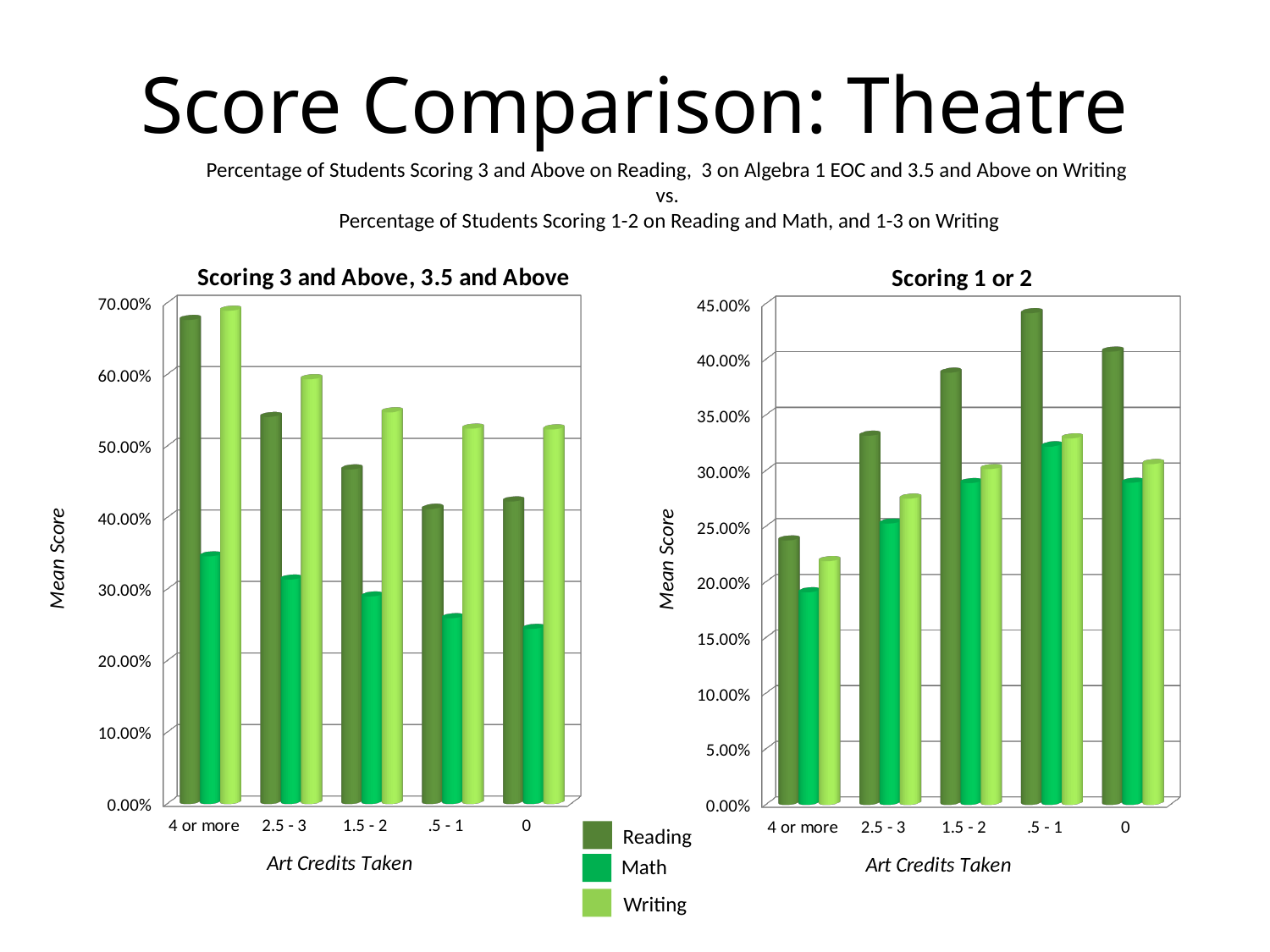
In the chart titled "Scoring 1 or 2", which is larger for "1.5 - 2": the Reading value or the Math value? Reading What is the y-axis title of the chart titled "Scoring 1 or 2"? Mean Score In the chart titled "Scoring 3 and Above, 3.5 and Above", which Art Credits Taken category has the highest Reading value? 4 or more In the chart titled "Scoring 3 and Above, 3.5 and Above", do the Math values rise or fall moving from "4 or more" to "0" along the x axis? fall How many series does the legend list for the charts on this slide? 3 In the chart titled "Scoring 1 or 2", is the Reading value for "0" greater or less than 35.00%? greater What kind of chart is the chart titled "Scoring 3 and Above, 3.5 and Above"? bar chart In the chart titled "Scoring 1 or 2", which Art Credits Taken category has the lowest Math value? 4 or more In the chart titled "Scoring 3 and Above, 3.5 and Above", is the Math value for "4 or more" greater or less than 30.00%? greater In the chart titled "Scoring 1 or 2", how many Art Credits Taken categories are shown on the x axis? 5 In the chart titled "Scoring 1 or 2", which Art Credits Taken category has the highest Reading value? .5 - 1 In the chart titled "Scoring 3 and Above, 3.5 and Above", is the Writing value for "2.5 - 3" greater or less than 50.00%? greater